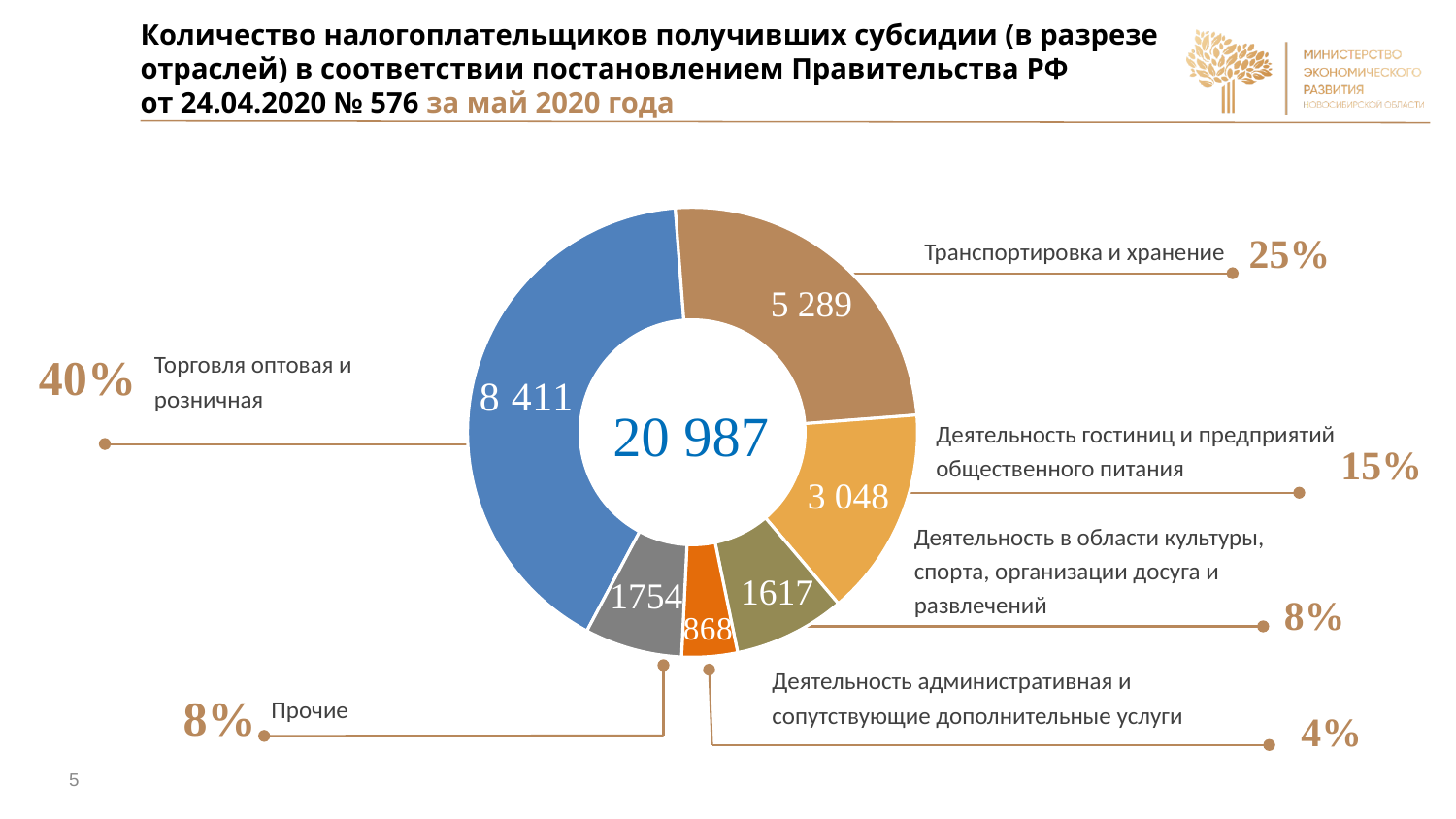
What is the difference between the values for "Торговля оптовая и розничная" and "Транспортировка и хранение"? 3 122 What share of the chart does "Деятельность в области культуры, спорта, организации досуга и развлечений" represent? 8% What value is shown for "Деятельность гостиниц и предприятий общественного питания"? 3 048 What value is shown for "Транспортировка и хранение"? 5 289 Which sector has the largest number of taxpayers who received subsidies? Торговля оптовая и розничная How many taxpayers received subsidies in the sector "Торговля оптовая и розничная"? 8 411 Which sector has the smallest number of taxpayers who received subsidies? Деятельность административная и сопутствующие дополнительные услуги What kind of chart is shown on the slide? Donut (pie) chart What share of the chart does "Транспортировка и хранение" represent? 25% What value is shown for "Деятельность административная и сопутствующие дополнительные услуги"? 868 Which is larger: the value for "Прочие" or the value for "Деятельность в области культуры, спорта, организации досуга и развлечений"? Прочие What total number is shown in the centre of the donut chart? 20 987